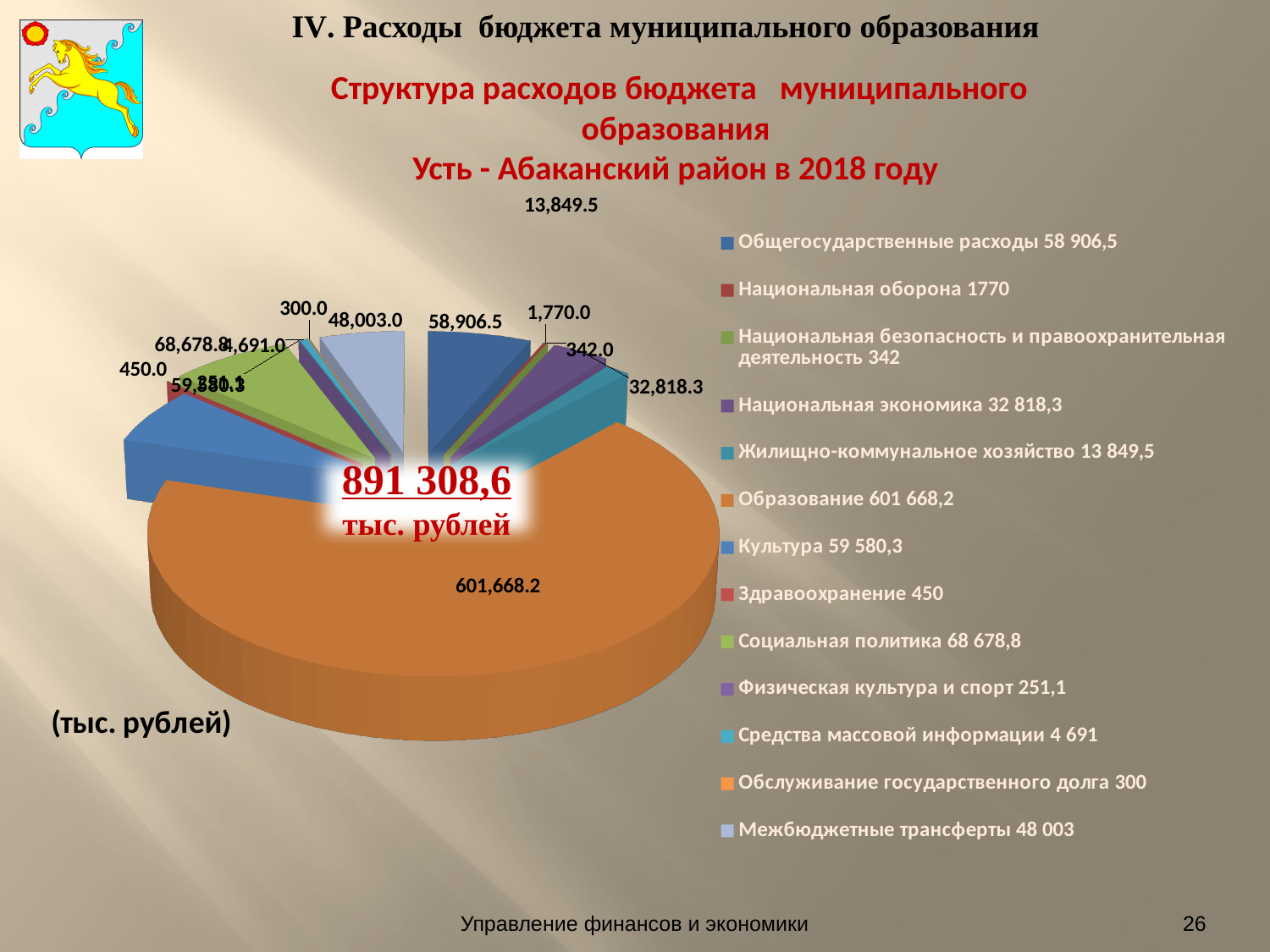
Which category has the largest slice of the pie? Образование Which category has the smallest value in the legend? Физическая культура и спорт What is the value shown for Общегосударственные расходы? 58,906.5 What kind of chart is shown on the slide? Pie chart What is the value shown for Межбюджетные трансферты? 48,003.0 What is the value shown for Национальная экономика? 32,818.3 How many categories does the legend list? 13 Which is larger: Национальная экономика or Межбюджетные трансферты? Межбюджетные трансферты What is the value shown for Жилищно-коммунальное хозяйство? 13,849.5 What total amount is printed in the centre of the pie chart? 891 308,6 тыс. рублей What is the difference between the values for Общегосударственные расходы and Межбюджетные трансферты? 10,903.5 What is the value shown for Образование? 601,668.2